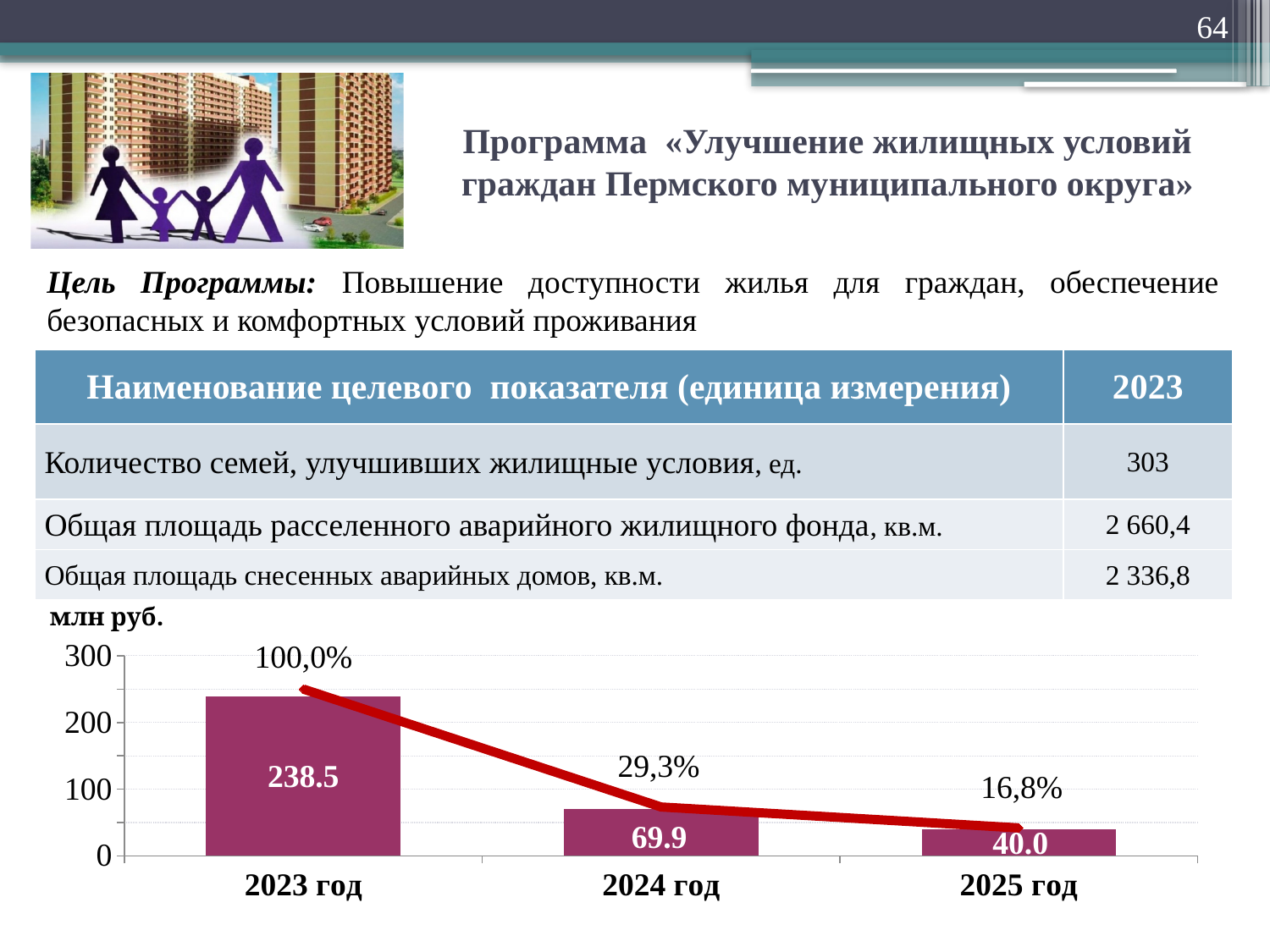
What is the value for 2025 год in the bar chart? 40.0 Do the bar values rise or fall from 2023 год to 2025 год? fall What is the difference between the values for 2023 год and 2024 год? 168.6 What is the value for 2024 год in the bar chart? 69.9 What is the difference between the values for 2024 год and 2025 год? 29.9 What is the value for 2023 год in the bar chart? 238.5 Which is larger, the value for 2024 год or the value for 2025 год? 2024 год What percentage label is shown on the line for 2024 год? 29,3% Which year has the lowest bar in the chart? 2025 год Is the value for 2023 год greater or less than 200? greater How many years are shown on the x axis of the chart? 3 Which year has the highest bar in the chart? 2023 год